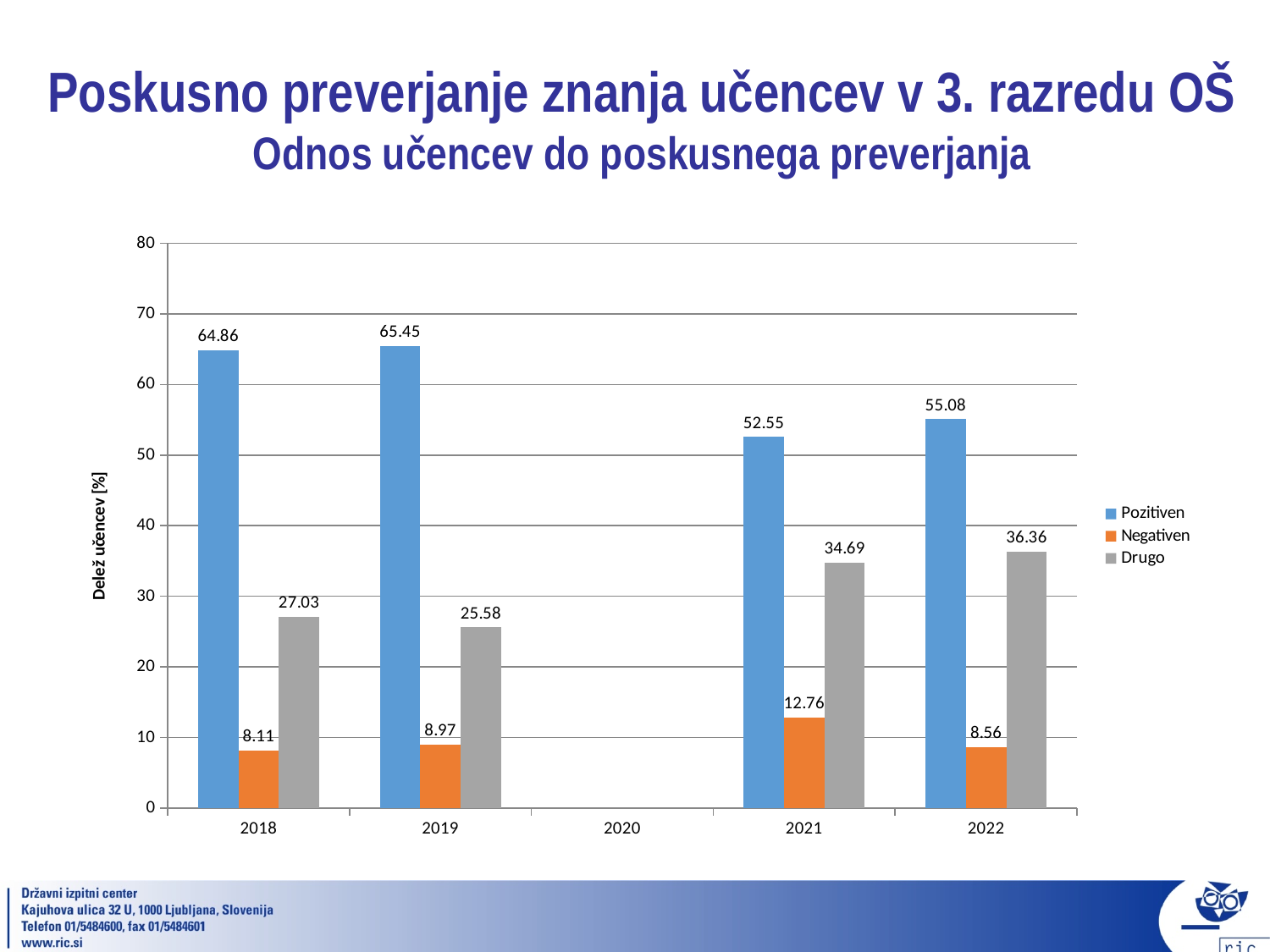
In which year is the Negativen value lowest? 2018 What is the value for Negativen in 2021? 12.76 How many years are shown on the x axis? 5 What is the difference between the Pozitiven values for 2019 and 2021? 12.9 Is the value for Pozitiven in 2022 greater or less than 50? greater What kind of chart is shown on the slide? bar chart What is the label of the y axis? Delež učencev [%] In which year is the Pozitiven value highest? 2019 Which is larger, the Drugo value for 2018 or for 2019? 2018 What is the value for Pozitiven in 2018? 64.86 How many series does the legend list? 3 What is the value for Drugo in 2022? 36.36